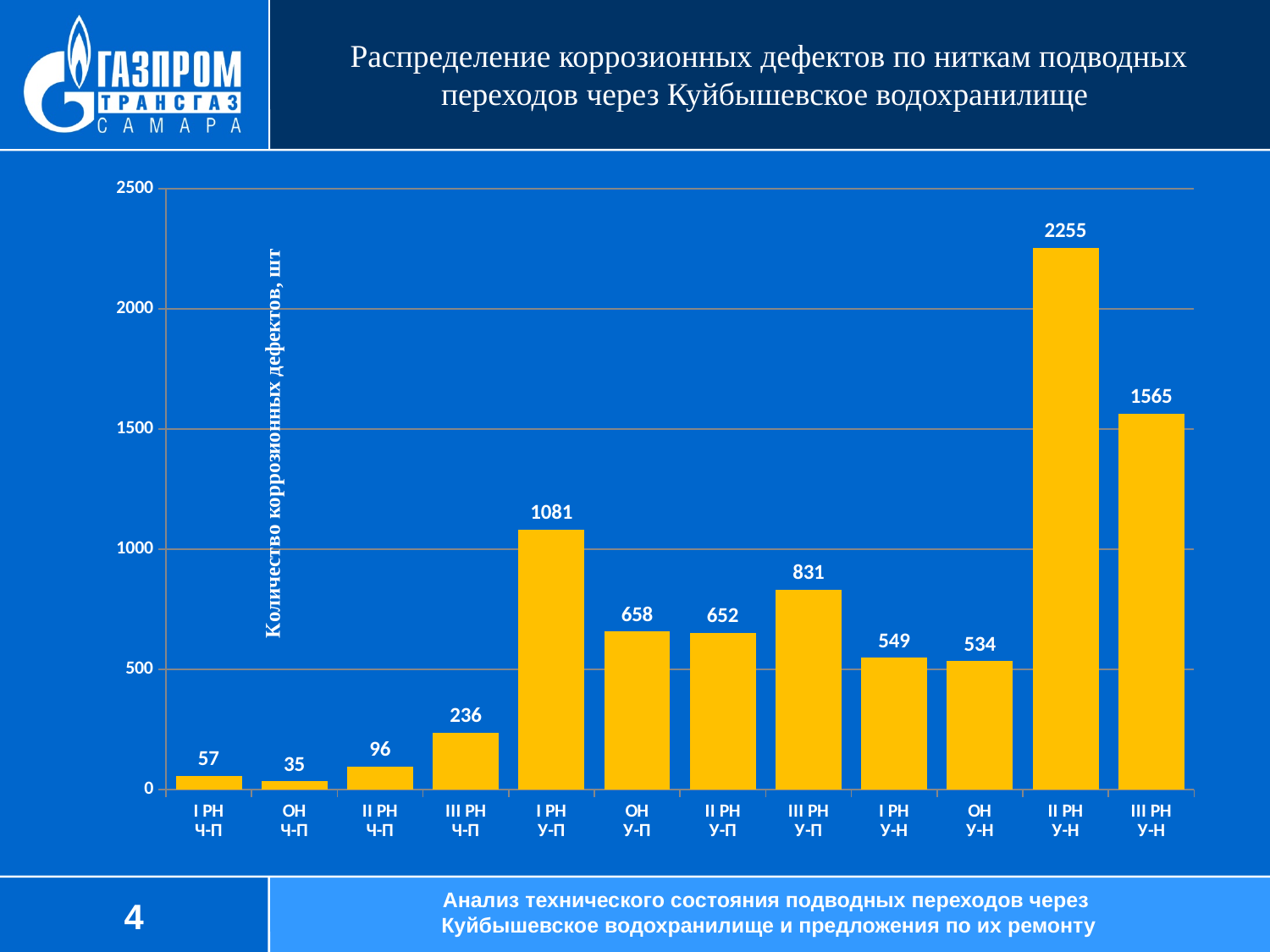
What is the value for III РН У-Н? 1565 What type of chart is shown on the slide? bar chart What is the value for I РН У-П? 1081 Which category has the lowest value? ОН Ч-П Is the value for I РН У-Н greater or less than 500? greater What is the value for II РН У-Н? 2255 Which is larger, the value for III РН У-П or the value for ОН У-П? III РН У-П What is the difference between the values for II РН У-Н and III РН У-Н? 690 How many bars (categories) are plotted in the chart? 12 What is the label of the vertical axis? Количество коррозионных дефектов, шт Which category has the highest value? II РН У-Н What is the value for ОН Ч-П? 35